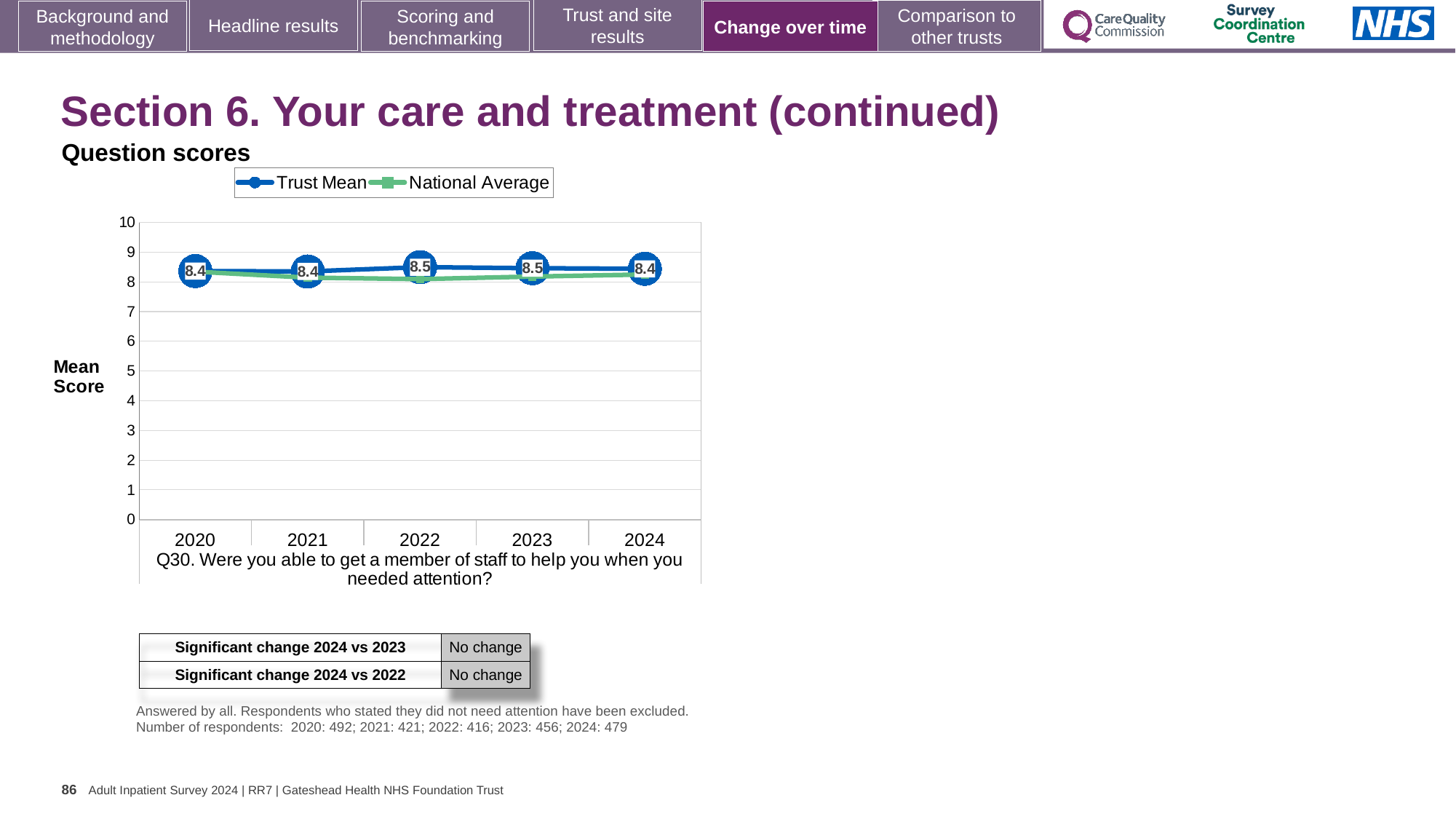
What kind of chart is shown on the slide? Line chart How many years are shown on the x axis of the chart? 5 What is the label of the y axis of the chart? Mean Score Does the Trust Mean score rise or fall from 2021 to 2022? Rise What is the difference between the Trust Mean score in 2023 and in 2024? 0.1 How many series does the chart legend list? 2 Is the National Average value for 2024 greater or less than 9? less What is the Trust Mean score for 2024? 8.4 What is the Trust Mean score for 2022? 8.5 What is the Trust Mean score for 2020? 8.4 Which is larger, the Trust Mean score for 2022 or for 2021? 2022 Is the National Average value for 2021 greater or less than 7? greater